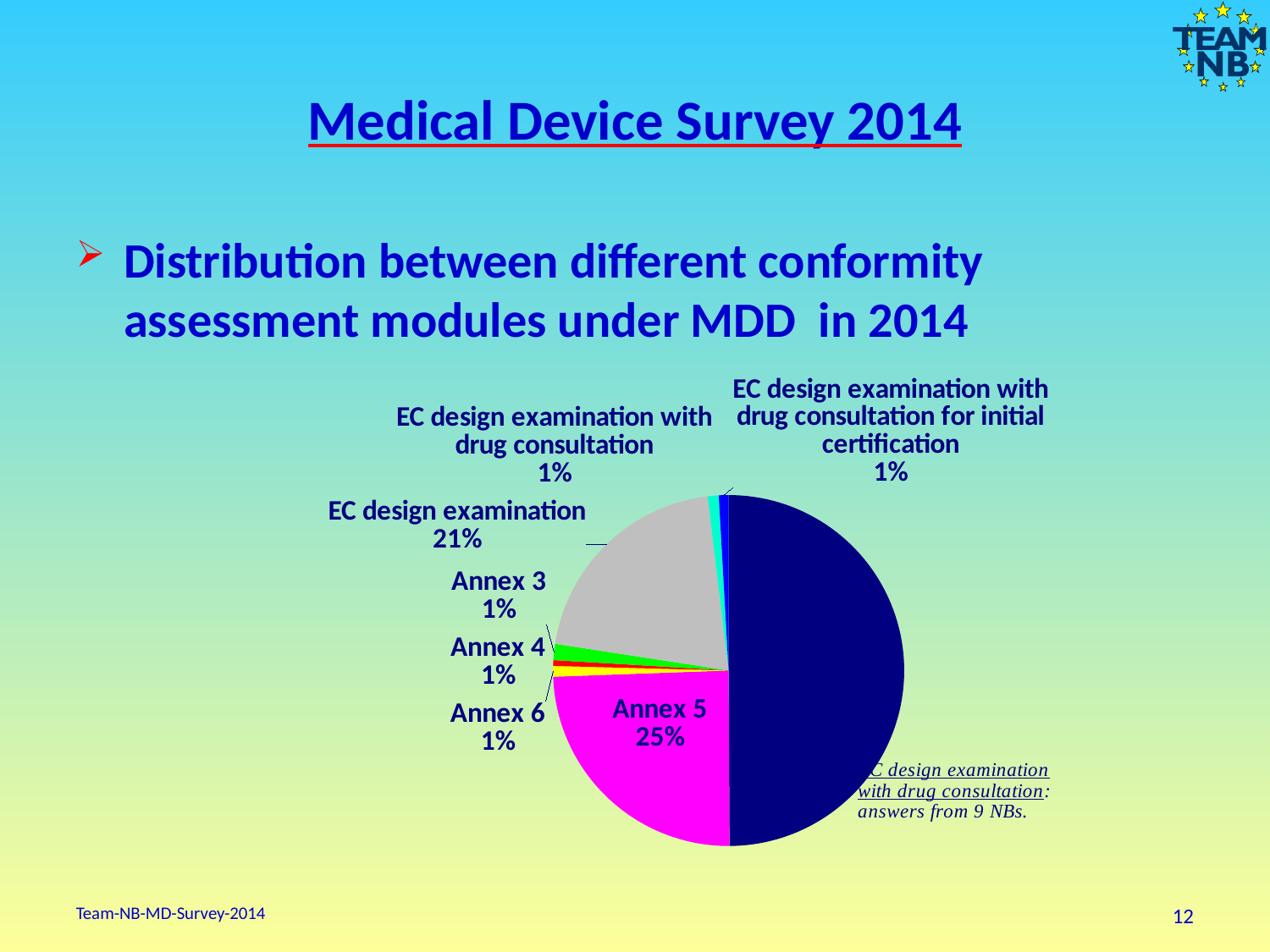
Which is larger, the share for Annex 5 or the share for EC design examination? Annex 5 Which is larger, the share for Annex 5 or the share for Annex 6? Annex 5 What percentage is shown for EC design examination? 21% What percentage is shown for Annex 4? 1% What percentage is shown for Annex 3? 1% What colour is the Annex 5 slice of the pie? magenta What percentage is shown for Annex 6? 1% What percentage is shown for EC design examination with drug consultation? 1% What percentage is shown for EC design examination with drug consultation for initial certification? 1% What share of the pie does Annex 5 represent? 25% What kind of chart is shown on the slide? pie chart What is the difference in percentage points between Annex 5 and EC design examination? 4